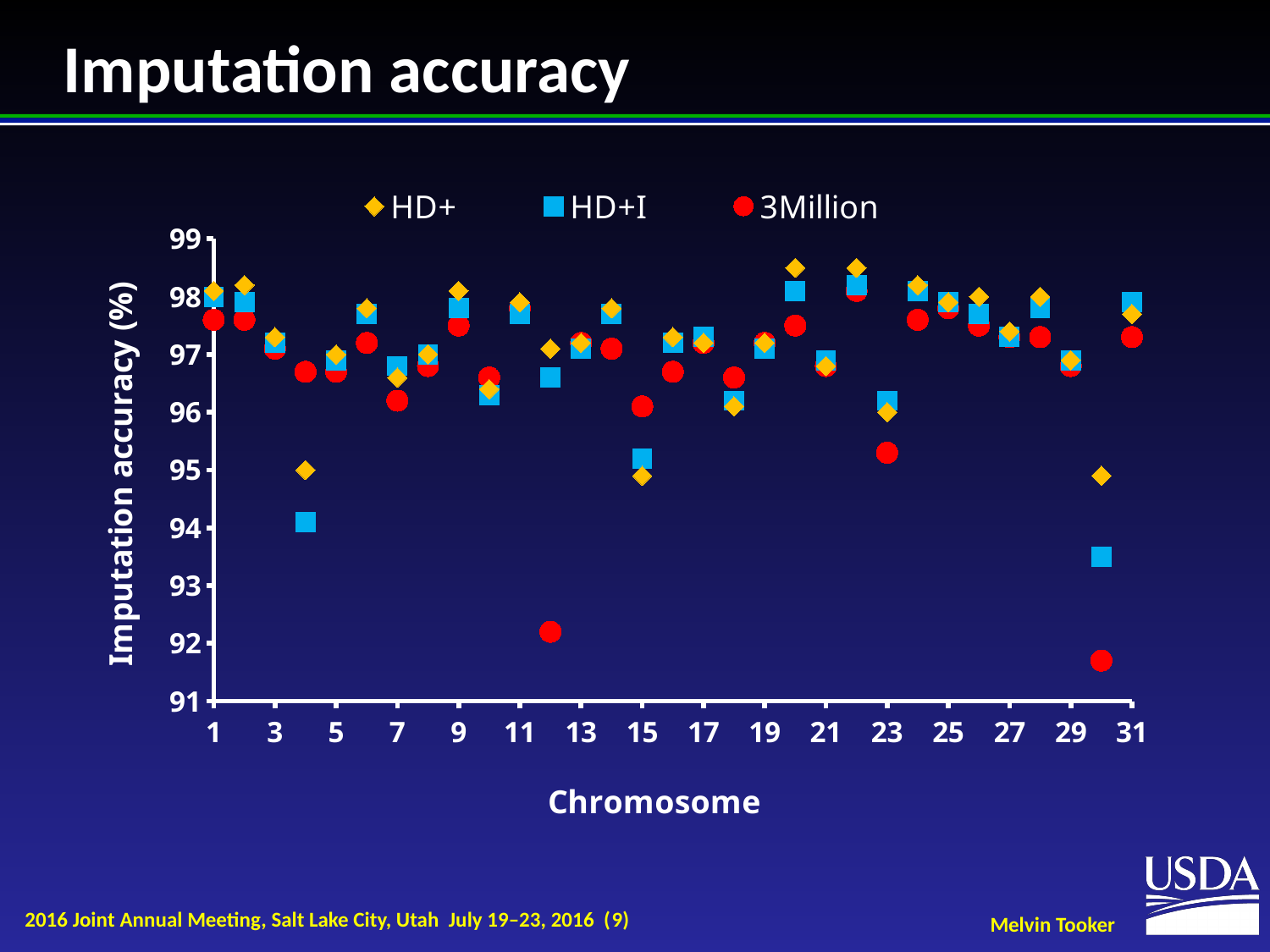
Is the 3Million value for chromosome 12 greater or less than 93? less Is the HD+I value for chromosome 4 greater or less than 95? less What kind of chart is shown on the slide? scatter chart At chromosome 4, which series has the higher value, HD+ or HD+I? HD+ Which chromosome has the lowest HD+I imputation accuracy? 30 Which chromosome has the lowest 3Million imputation accuracy? 30 How many series does the legend list? 3 Is the 3Million value for chromosome 30 greater or less than 92? less What is the title of the y axis? Imputation accuracy (%) At chromosome 30, which series has the higher value, HD+ or 3Million? HD+ What are the three series named in the legend? HD+, HD+I, 3Million